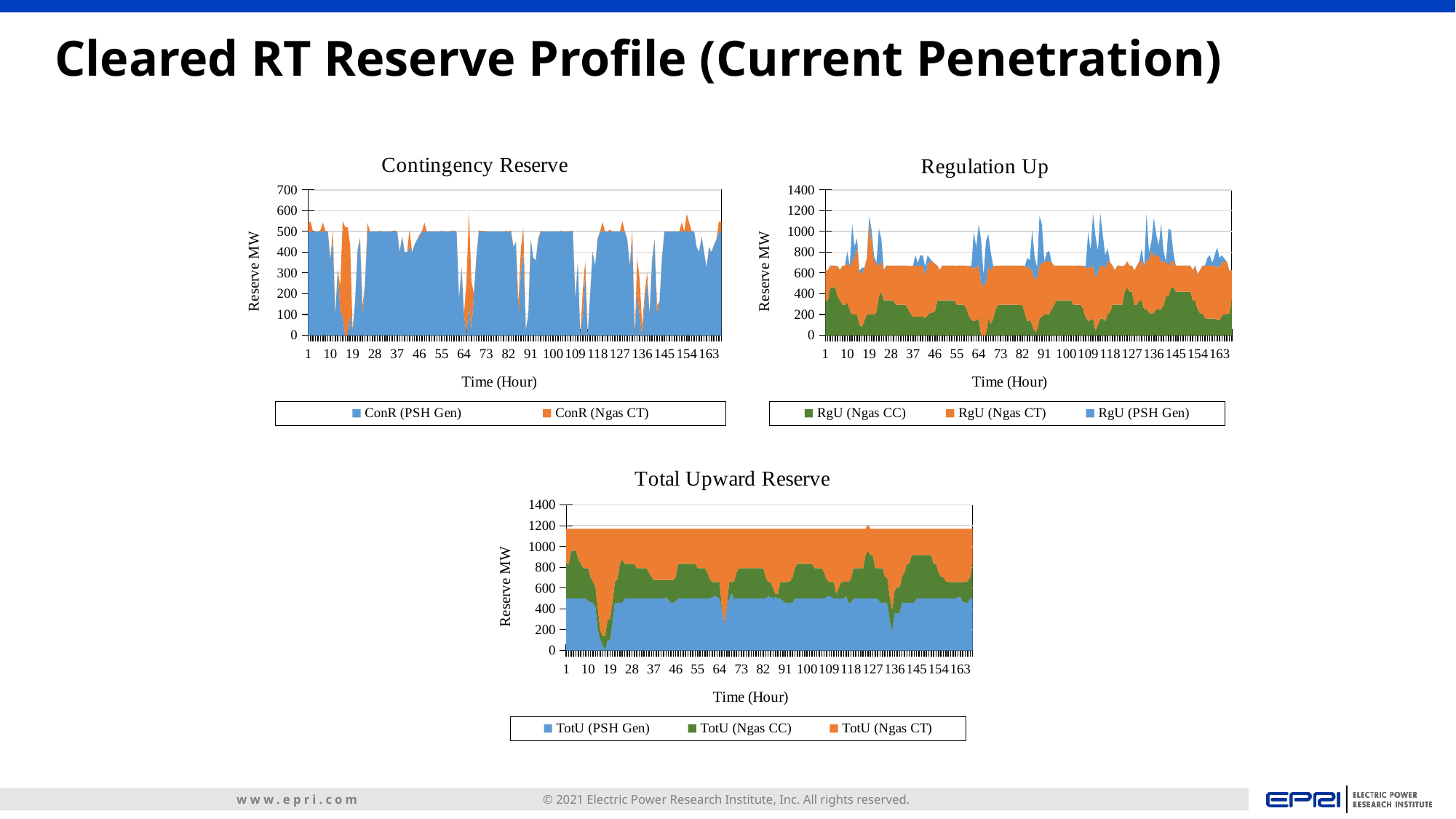
How many charts are shown on the slide? 3 How many series does the legend of the Contingency Reserve chart list? 2 In the Total Upward Reserve chart, is the TotU (PSH Gen) value at hour 10 greater or less than 400? greater In the Contingency Reserve chart, is the ConR (PSH Gen) value at hour 28 greater or less than 400? greater In the Regulation Up chart, is the total stacked value at hour 1 greater or less than 1000? less How many series does the legend of the Regulation Up chart list? 3 Which two series are listed in the legend of the Contingency Reserve chart? ConR (PSH Gen) and ConR (Ngas CT) What kind of chart is the Total Upward Reserve chart? Stacked area chart What is the y-axis label on the Contingency Reserve chart? Reserve MW How many series does the legend of the Total Upward Reserve chart list? 3